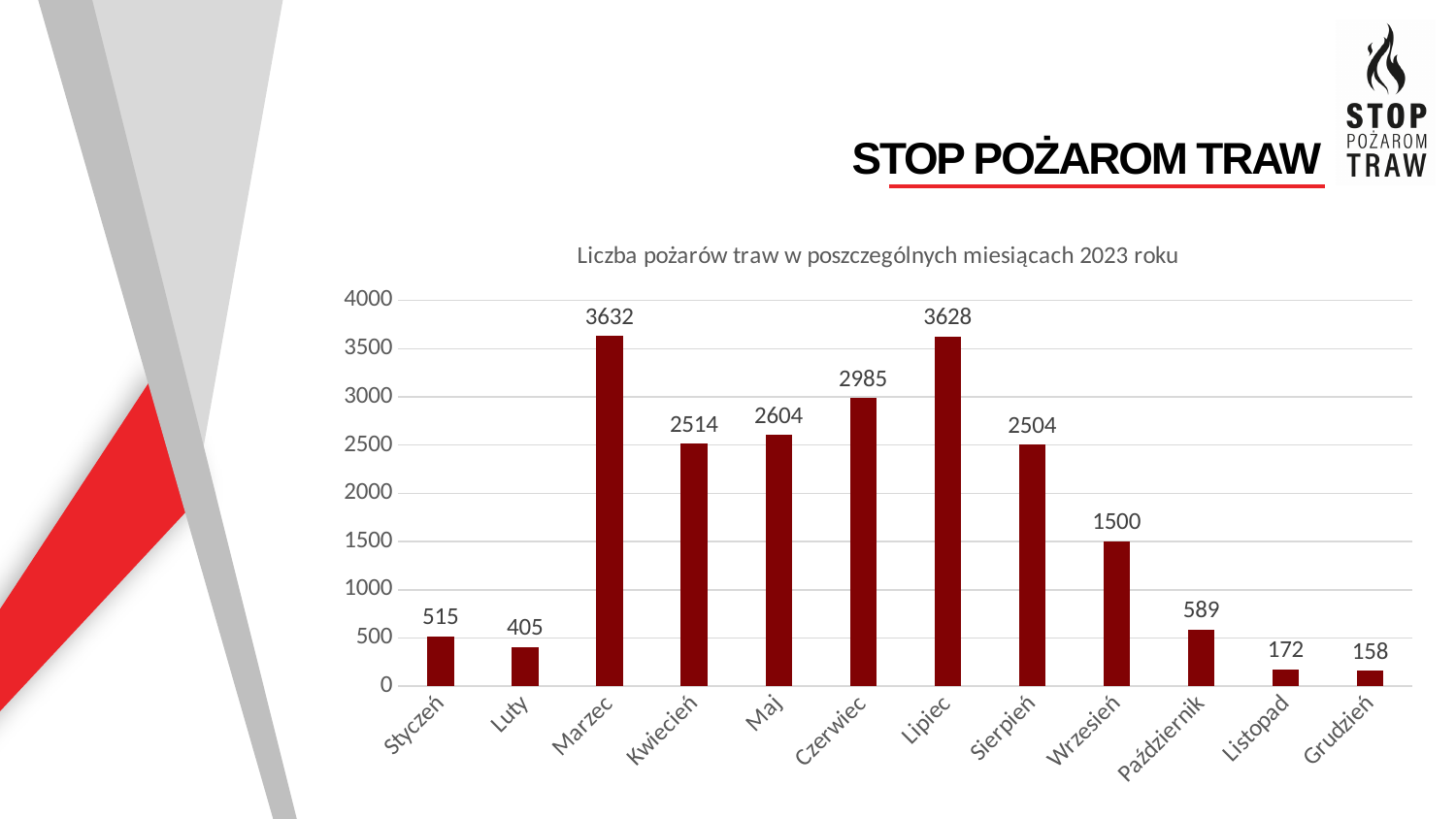
Is the value for Październik greater or less than 1000? less Which is larger, the value for Maj or the value for Kwiecień? Maj What is the difference between the values for Marzec and Lipiec? 4 How many months (categories) are shown on the x axis? 12 Which month has the highest value? Marzec What is the difference between the values for Czerwiec and Maj? 381 What type of chart is shown on the slide? bar chart What is the value for Marzec? 3632 What is the value for Wrzesień? 1500 What is the value for Luty? 405 What is the title of the chart? Liczba pożarów traw w poszczególnych miesiącach 2023 roku Which month has the lowest value? Grudzień